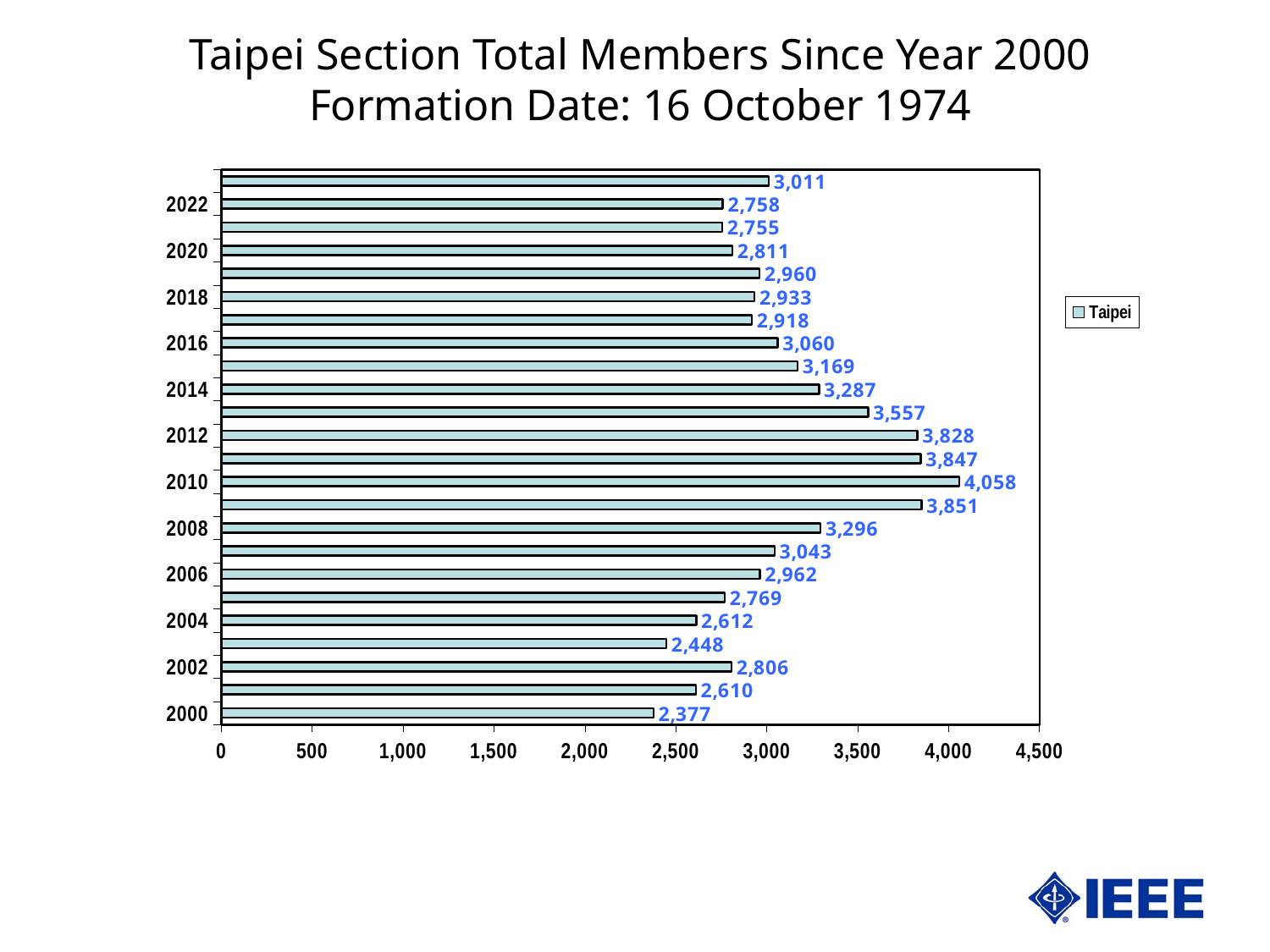
What is the value for 2000? 2,377 Which is larger, the value for 2008 or the value for 2018? 2008 What is the value for 2022? 2,758 What is the value for 2010? 4,058 Which year has the lowest value? 2000 What is the value for 2016? 3,060 What series name does the legend show? Taipei What is the difference between the values for 2012 and 2014? 541 Is the value for 2006 greater or less than 3,000? less What is the difference between the values for 2010 and 2000? 1,681 What kind of chart is this? bar chart Which year has the highest value? 2010